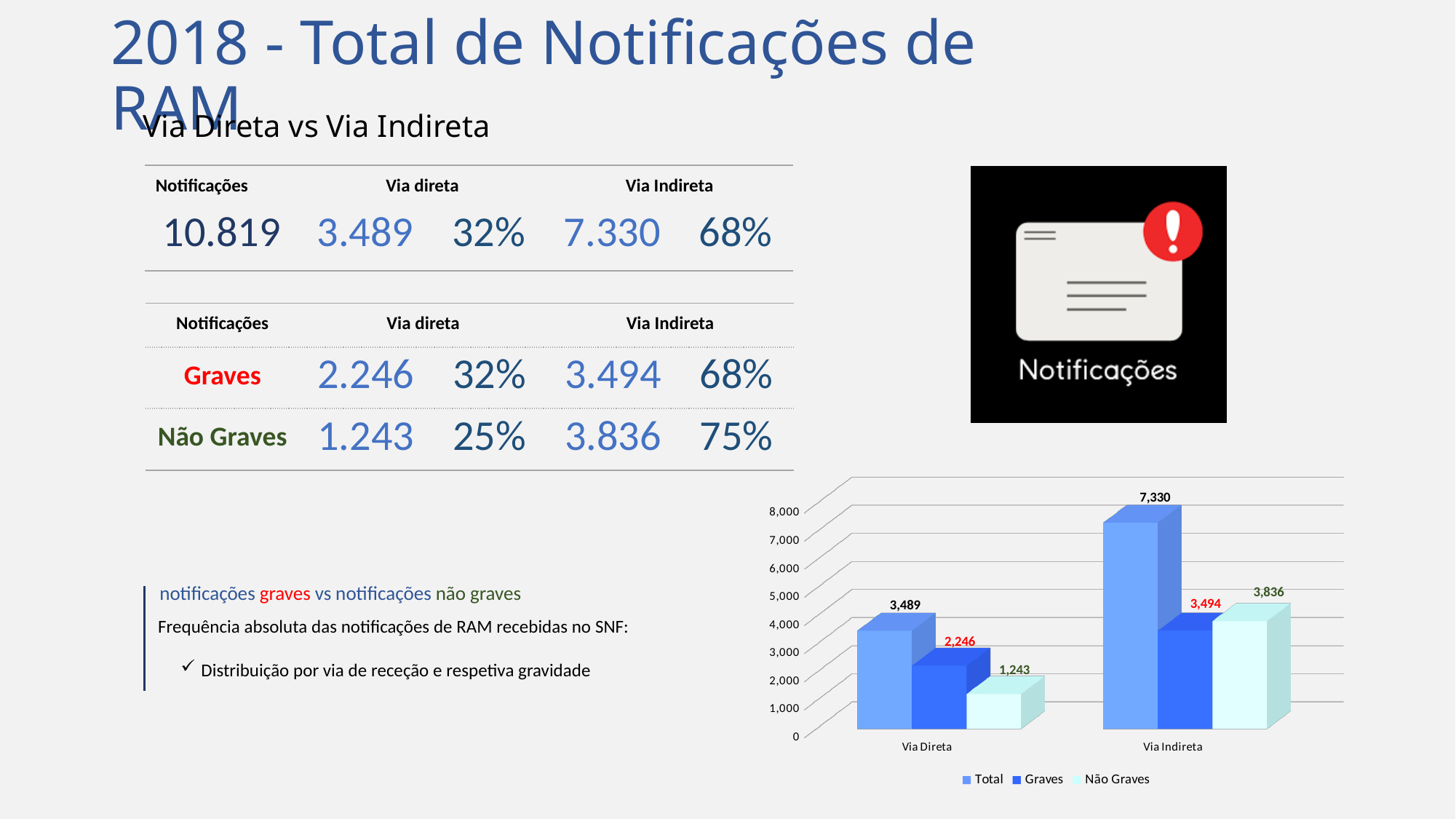
What is the Total value for Via Direta in the bar chart? 3,489 What is the Graves value for Via Indireta in the bar chart? 3,494 What kind of chart is shown on the slide? Bar chart How many series does the legend of the bar chart list? 3 Which category has the higher Total value in the bar chart? Via Indireta What is the Total value for Via Indireta in the bar chart? 7,330 What is the Não Graves value for Via Direta in the bar chart? 1,243 How many categories are shown on the x axis of the bar chart? 2 Which series has the lowest value for Via Direta in the bar chart? Não Graves What is the difference between the Total values for Via Indireta and Via Direta in the bar chart? 3,841 Is the Não Graves value for Via Indireta greater or less than 3,000 in the bar chart? greater Is the Graves value for Via Direta larger or smaller than the Não Graves value for Via Direta in the bar chart? larger